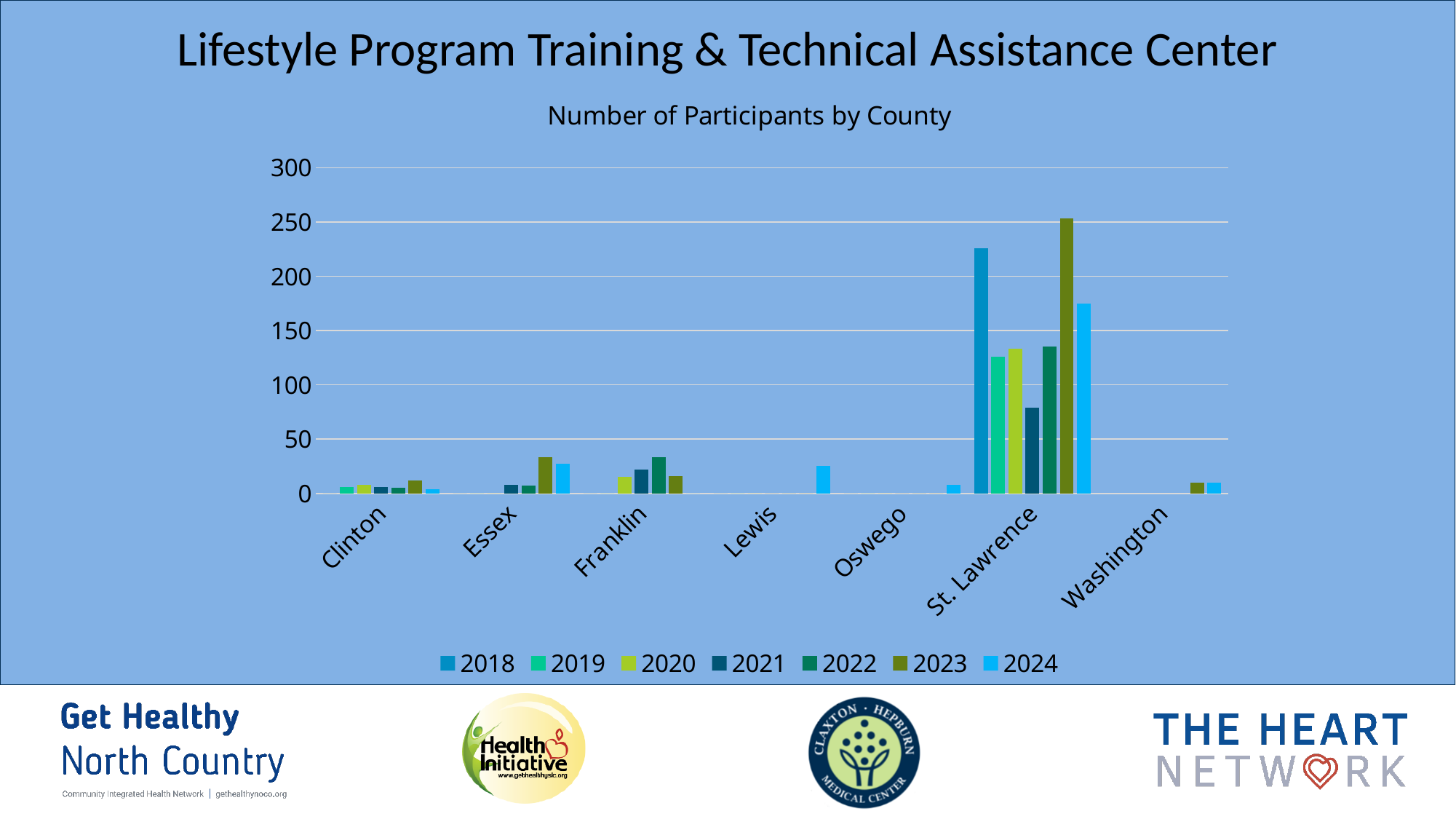
For St. Lawrence, which year has the tallest bar? 2023 Is the value for St. Lawrence in 2023 greater or less than 200? greater What kind of chart is shown on the slide? bar chart How many counties are shown on the x axis of the chart? 7 Is the value for St. Lawrence in 2024 greater or less than 150? greater Is the value for St. Lawrence in 2021 greater or less than 100? less How many series (years) does the legend list? 7 For St. Lawrence, which is larger: the 2018 value or the 2024 value? 2018 What is the title of the chart? Number of Participants by County For St. Lawrence, which is larger: the 2021 value or the 2022 value? 2022 Which county has the highest number of participants in the chart? St. Lawrence